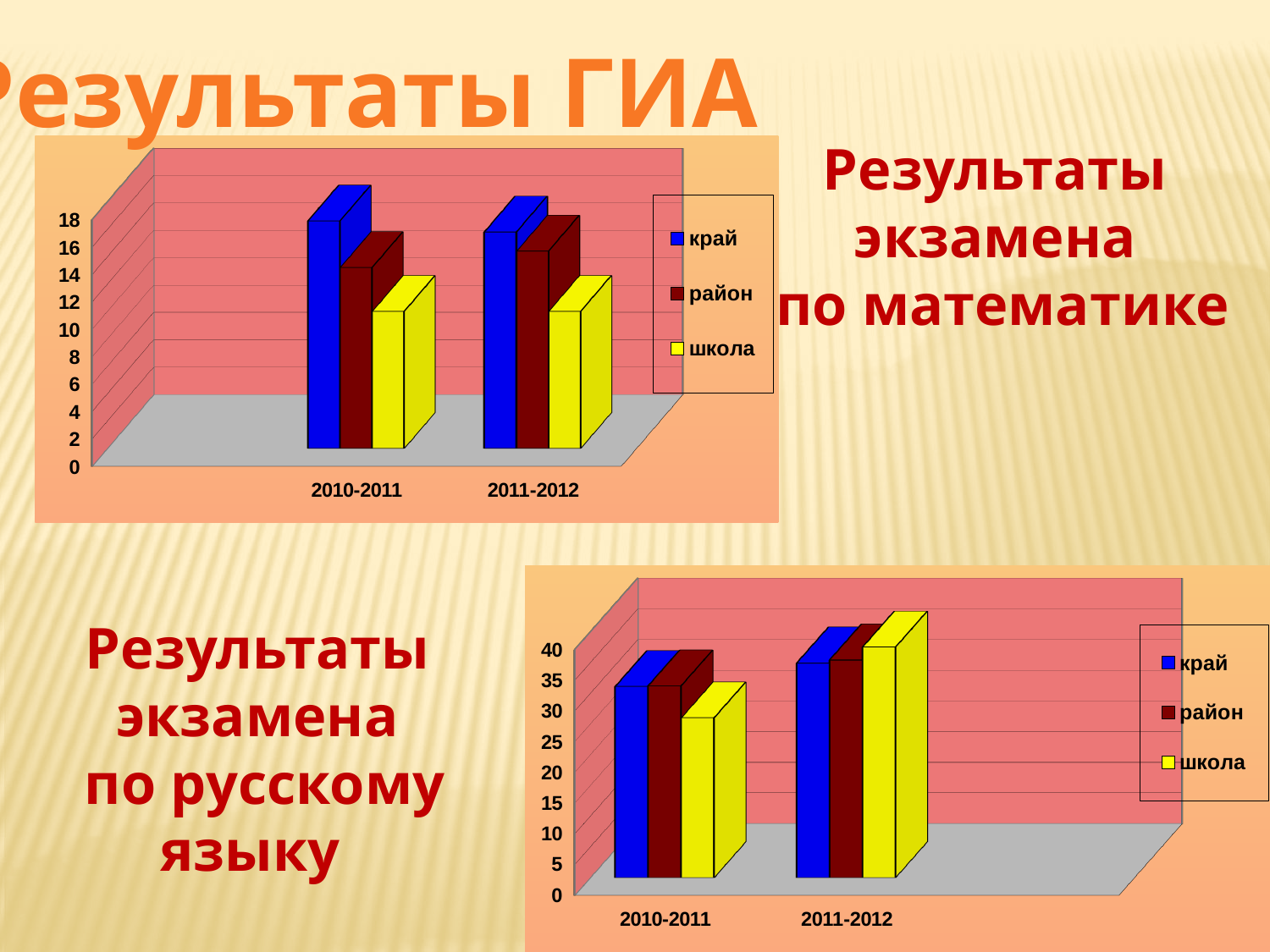
How many series does the legend of the top chart (Результаты экзамена по математике) list? 3 What are the legend entries of the bottom chart (Результаты экзамена по русскому языку)? край, район, школа How many categories are shown on the x axis of the top chart (Результаты экзамена по математике)? 2 In the top chart (Результаты экзамена по математике), is the value for школа in 2010-2011 greater or less than 14? less What kind of chart is the top chart (Результаты экзамена по математике)? bar chart In the bottom chart (Результаты экзамена по русскому языку), does the value for школа rise or fall from 2010-2011 to 2011-2012? rise In the top chart (Результаты экзамена по математике), is the value for край in 2010-2011 greater or less than 10? greater In the bottom chart (Результаты экзамена по русскому языку), is the value for школа in 2010-2011 greater or less than 35? less In the bottom chart (Результаты экзамена по русскому языку), which series has the lowest value for 2010-2011? школа In the top chart (Результаты экзамена по математике), which series has the lowest value for 2010-2011? школа In the top chart (Результаты экзамена по математике), which series has the highest value for 2010-2011? край In the bottom chart (Результаты экзамена по русскому языку), which series has the highest value for 2011-2012? школа